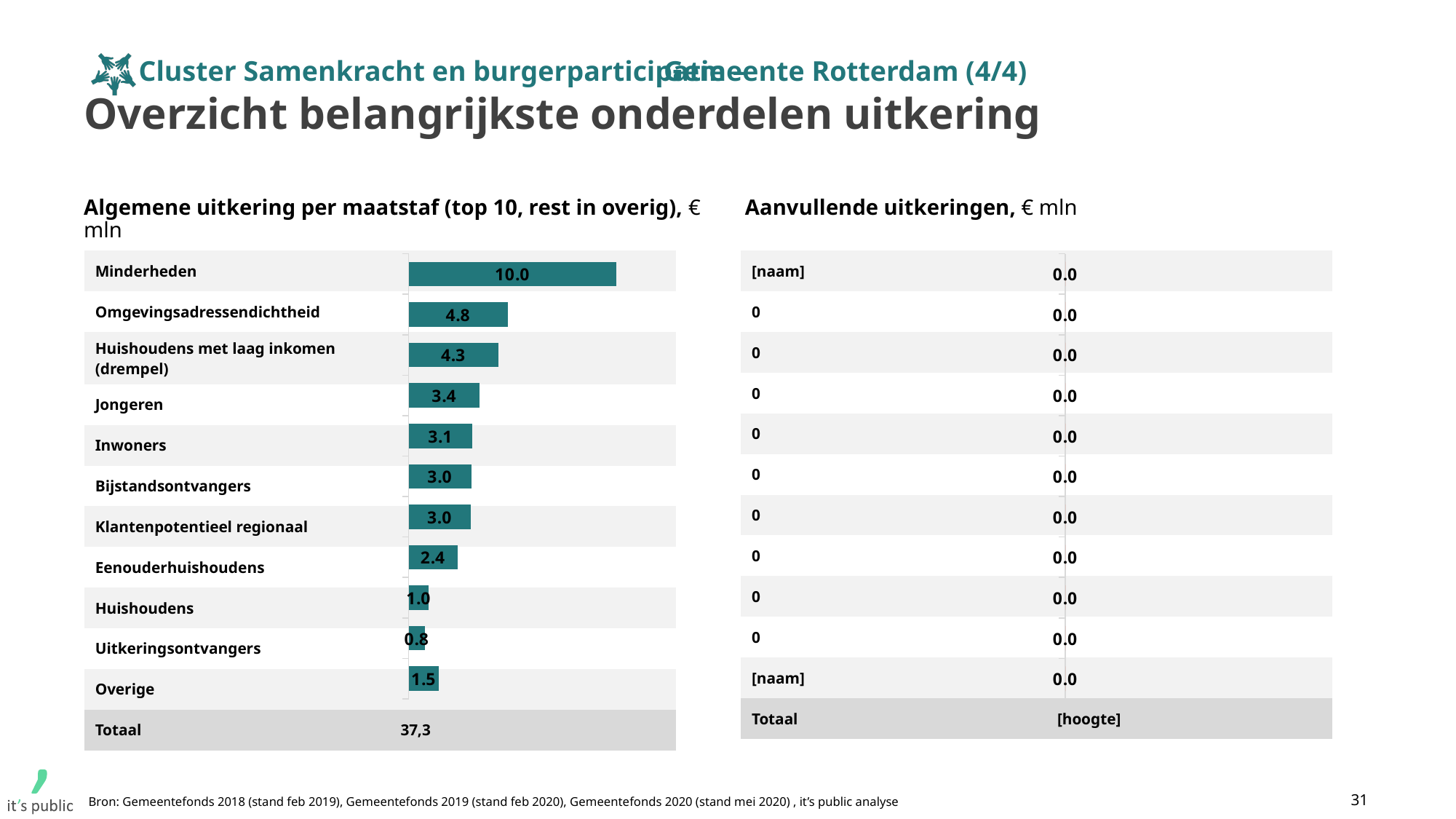
In the chart 'Algemene uitkering per maatstaf', what is the value for Eenouderhuishoudens? 2.4 In the chart 'Algemene uitkering per maatstaf', which category has the lowest value? Uitkeringsontvangers In the chart 'Algemene uitkering per maatstaf', what is the value for Minderheden? 10.0 In the chart 'Algemene uitkering per maatstaf', what is the value shown for Totaal? 37,3 In the chart 'Algemene uitkering per maatstaf', what is the value for Omgevingsadressendichtheid? 4.8 In the chart 'Algemene uitkering per maatstaf', what is the difference between the values for Minderheden and Omgevingsadressendichtheid? 5.2 In the chart 'Algemene uitkering per maatstaf', what is the value for Overige? 1.5 What kind of chart is 'Algemene uitkering per maatstaf'? Bar chart In the chart 'Algemene uitkering per maatstaf', how many categories are shown as bars? 11 In the chart 'Algemene uitkering per maatstaf', which category has the highest value? Minderheden What unit is stated in the title of the chart 'Algemene uitkering per maatstaf'? € mln In the chart 'Algemene uitkering per maatstaf', which is larger: the value for Jongeren or the value for Inwoners? Jongeren